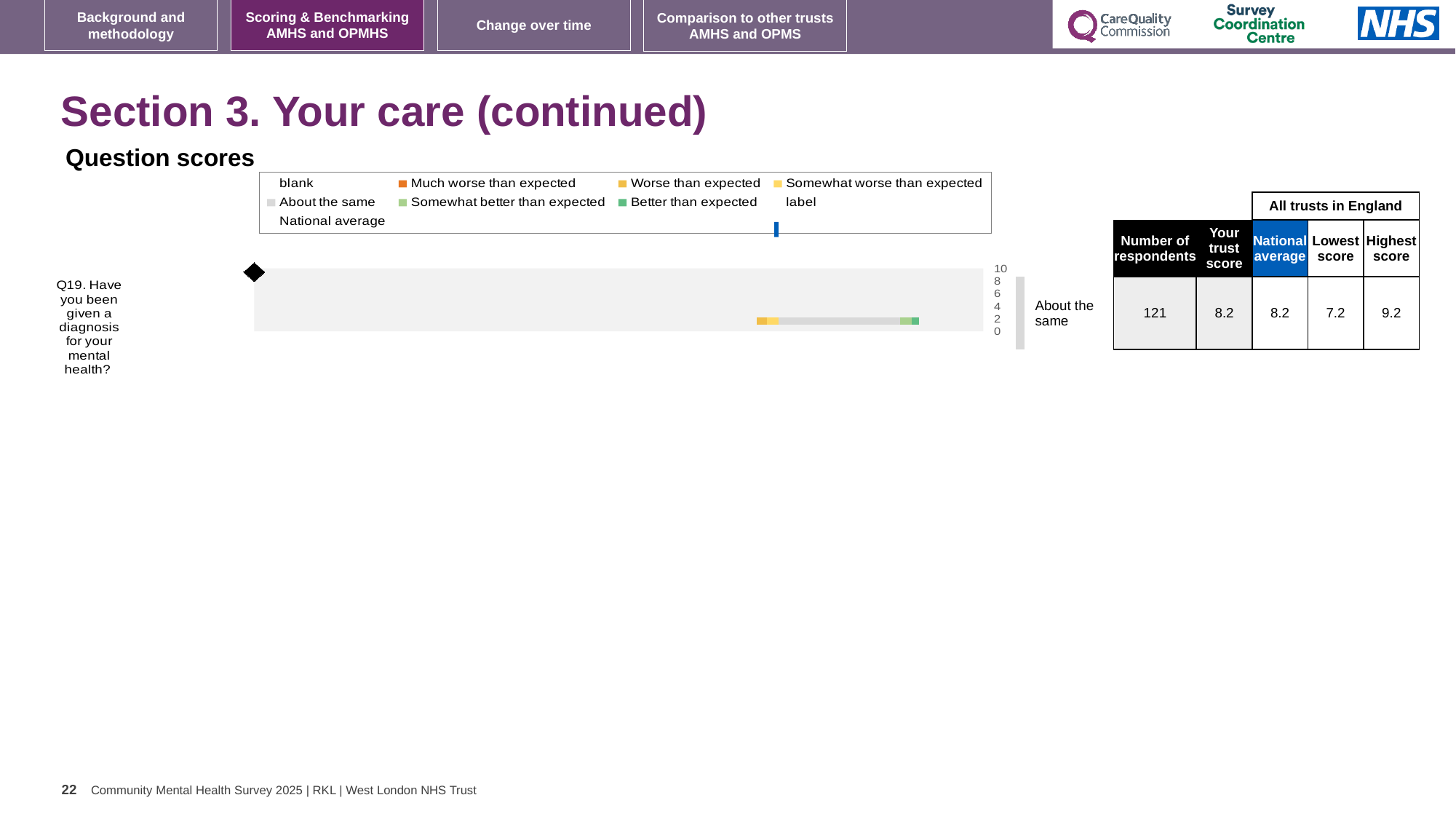
What is the lowest score among all trusts in England for Q19? 7.2 What is the highest score among all trusts in England for Q19? 9.2 What is the national average score for Q19? 8.2 What is the highest value shown on the chart's score axis? 10 What is the trust's score for Q19? 8.2 What is the number of respondents for Q19? 121 Is the trust's score for Q19 higher than, lower than, or equal to the national average? equal What kind of chart is shown under 'Question scores'? bar chart What is the difference between the highest score and the lowest score for Q19? 2.0 How many survey questions are plotted in the Question scores chart? 1 What benchmark category is shown next to the bar for Q19? About the same Which question is plotted in the Question scores chart? Q19. Have you been given a diagnosis for your mental health?